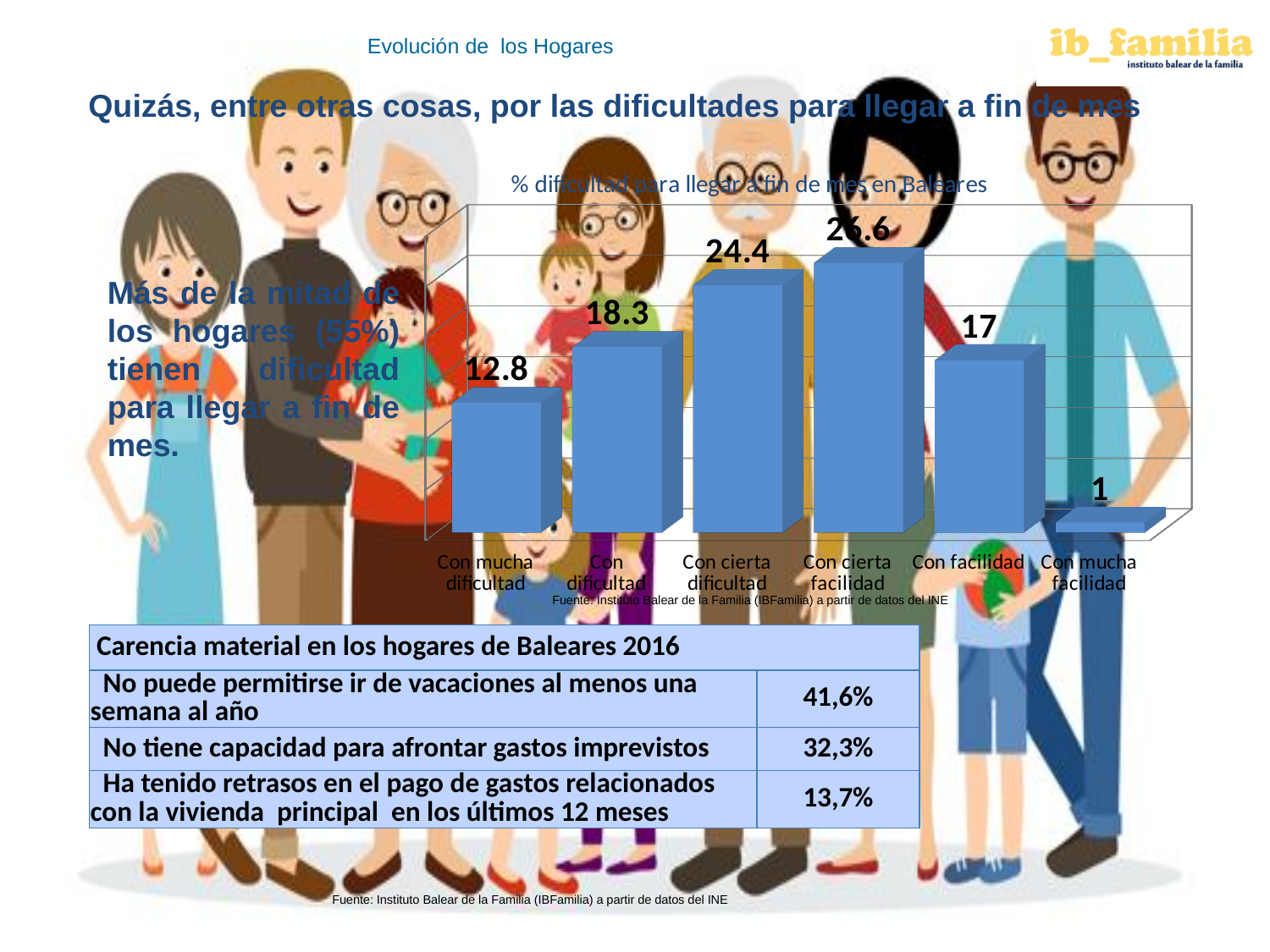
What is the value for "Con facilidad"? 17 What is the difference between the values for "Con cierta facilidad" and "Con facilidad"? 9.6 How many categories are shown in the chart? 6 Which category has the lowest value? Con mucha facilidad What is the value for "Con mucha dificultad"? 12.8 Which is larger, the value for "Con dificultad" or the value for "Con facilidad"? Con dificultad Which category has the highest value? Con cierta facilidad What kind of chart is shown on the slide? Bar chart What is the difference between the values for "Con cierta dificultad" and "Con dificultad"? 6.1 What is the value for "Con cierta facilidad"? 26.6 What is the title of the chart? % dificultad para llegar a fin de mes en Baleares What is the value for "Con mucha facilidad"? 1